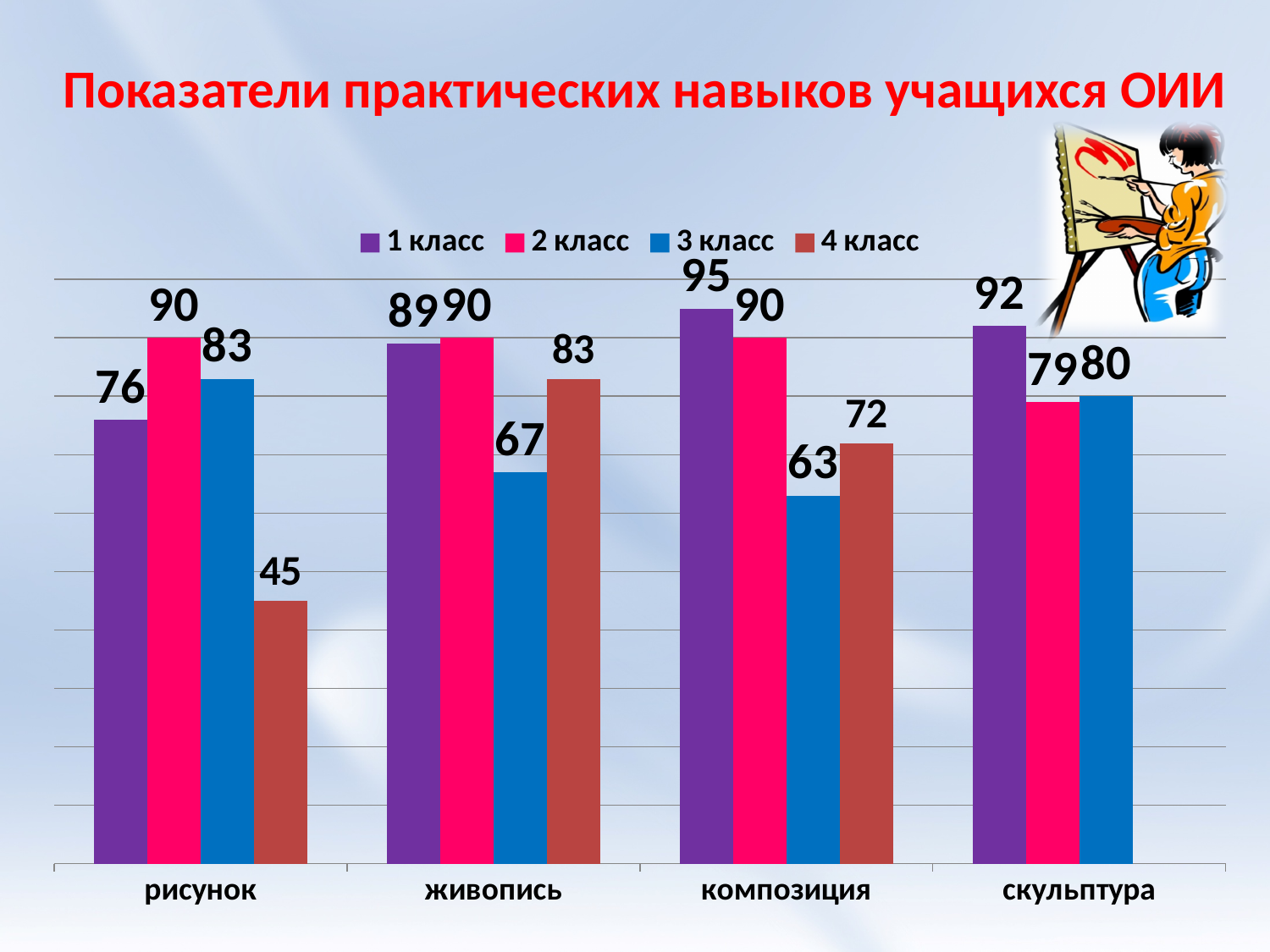
What is the value for 4 класс in the живопись category? 83 What is the difference between the 2 класс and 4 класс values in the рисунок category? 45 What kind of chart is shown on the slide? bar chart What is the title of the slide? Показатели практических навыков учащихся ОИИ What is the value for 1 класс in the рисунок category? 76 What is the value for 2 класс in the скульптура category? 79 How many categories are shown on the x axis? 4 How many series does the legend list? 4 Which is larger in the живопись category: the value for 3 класс or the value for 4 класс? 4 класс Which category has the highest value for 1 класс? композиция What is the value for 3 класс in the композиция category? 63 Which category has the lowest value for 4 класс? рисунок